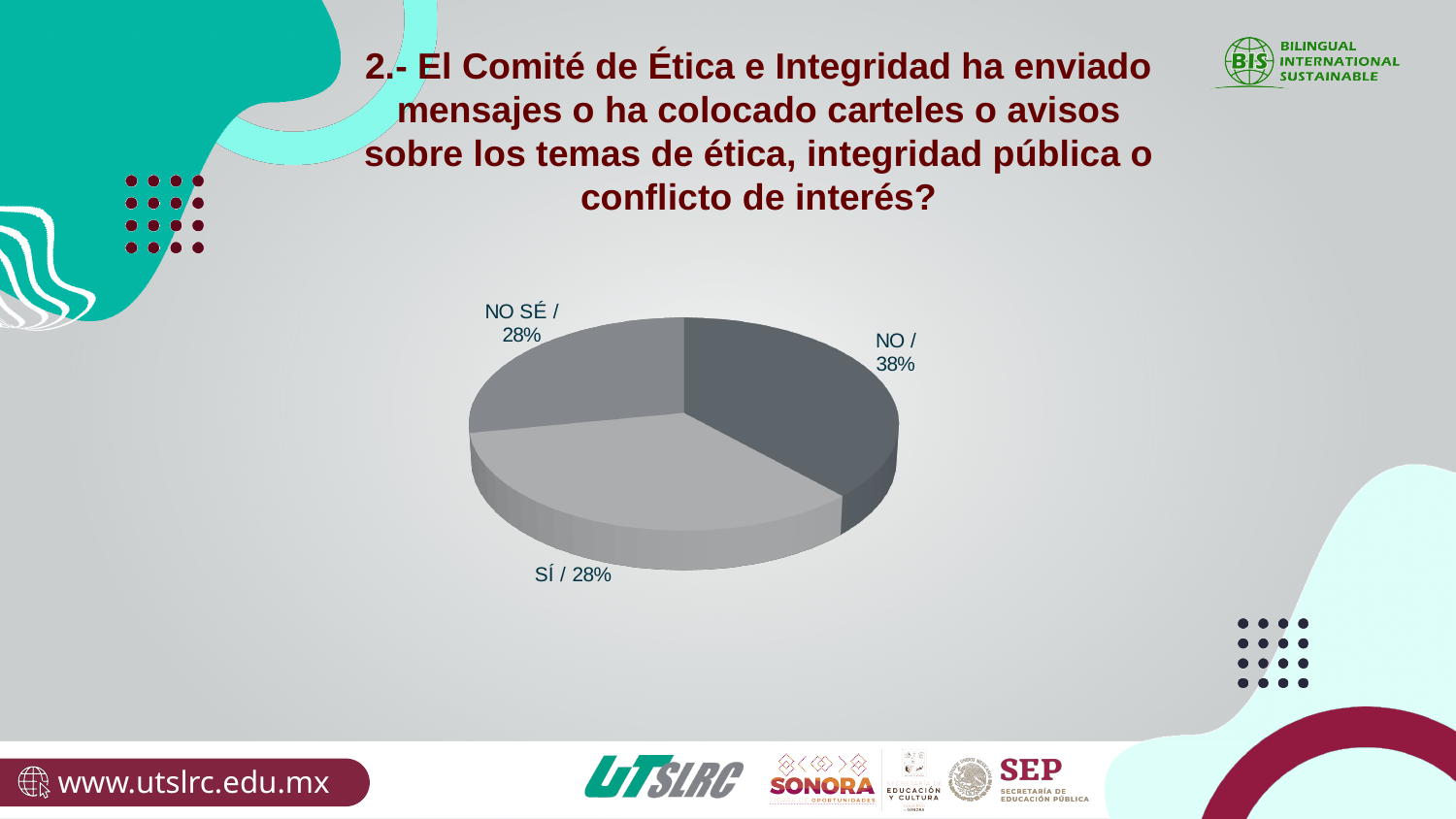
What percentage of the pie chart corresponds to "NO"? 38% What kind of chart is shown on the slide? pie chart What question number is shown in the slide title above the chart? 2 What percentage of the pie chart corresponds to "SÍ"? 28% How many slices does the pie chart have? 3 Is the value for "NO" greater or less than 30%? greater What is the difference in percentage points between the "NO" slice and the "SÍ" slice? 10 Which slice is larger, "NO" or "NO SÉ"? NO Which category has the largest slice of the pie chart? NO What share of the pie does the "NO" slice represent? 38% What percentage of the pie chart corresponds to "NO SÉ"? 28%